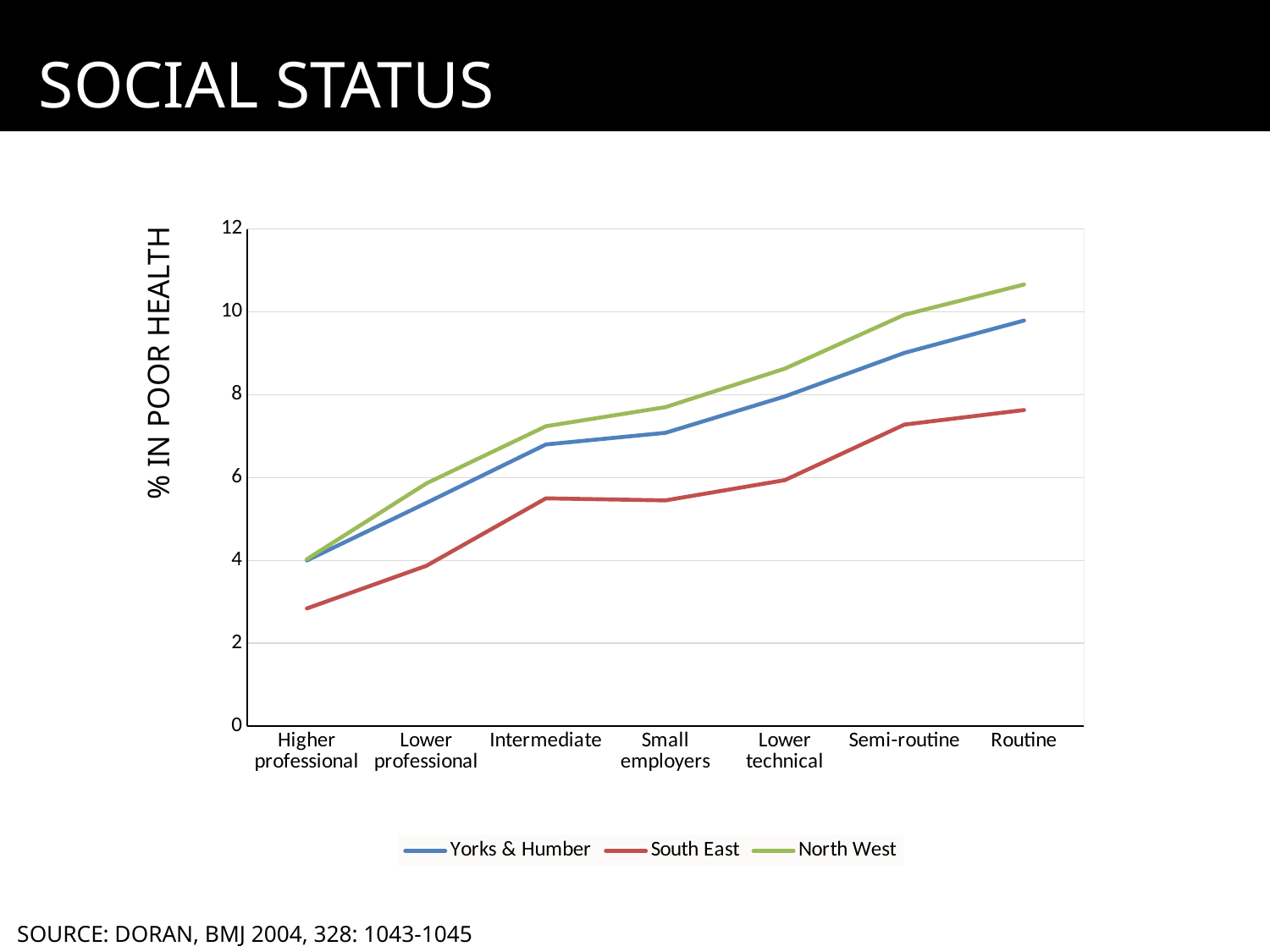
At Routine, which series has the larger value, North West or South East? North West For the North West series, which category has the lowest value? Higher professional Is the value for Yorks & Humber at Semi-routine greater or less than 8? greater Is the value for South East at Higher professional greater or less than 4? less How many social status categories are shown on the x axis? 7 Is the value for North West at Routine greater or less than 10? greater What is the title of the vertical axis? % IN POOR HEALTH How many series does the legend list? 3 Do the values for North West rise or fall from Higher professional to Routine? rise What kind of chart is shown on the slide? line chart For the South East series, which category has the highest value? Routine